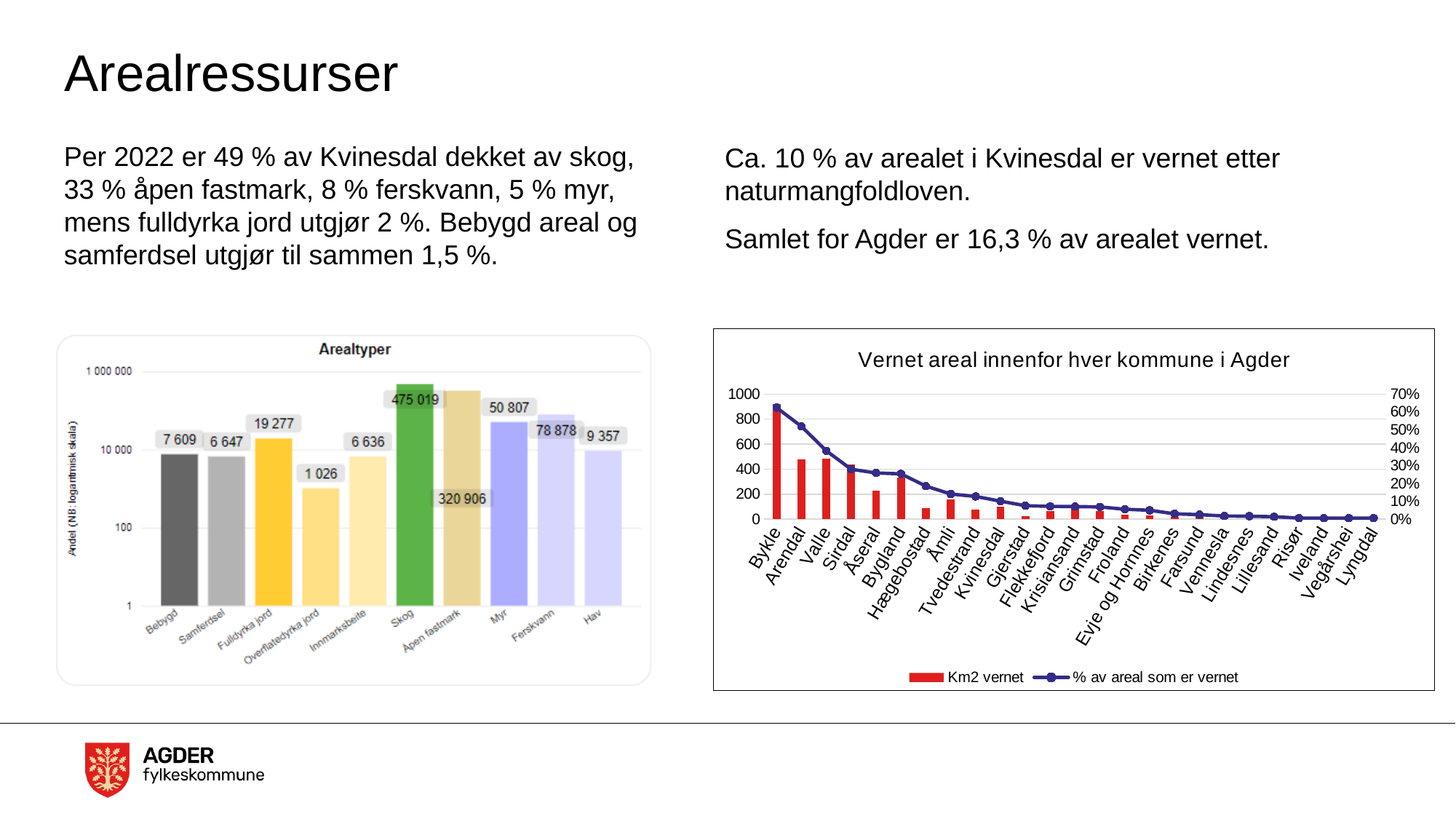
In the chart 'Vernet areal innenfor hver kommune i Agder', is the Km2 vernet value for Bykle greater or less than 800? greater In the chart 'Vernet areal innenfor hver kommune i Agder', which municipality has the highest Km2 vernet? Bykle In the chart 'Vernet areal innenfor hver kommune i Agder', does the '% av areal som er vernet' line rise or fall from left to right? fall In the Arealtyper chart, which is larger, Bebygd or Samferdsel? Bebygd How many series does the legend of the chart 'Vernet areal innenfor hver kommune i Agder' list? 2 In the Arealtyper chart, what is the value for Overflatedyrka jord? 1 026 In the Arealtyper chart, which category has the lowest value? Overflatedyrka jord In the Arealtyper chart, which category has the highest value? Skog In the Arealtyper chart, what is the value for Ferskvann? 78 878 How many categories are shown in the Arealtyper chart? 10 In the Arealtyper chart, what is the difference between Skog and Åpen fastmark? 154 113 In the Arealtyper chart, what is the value for Skog? 475 019